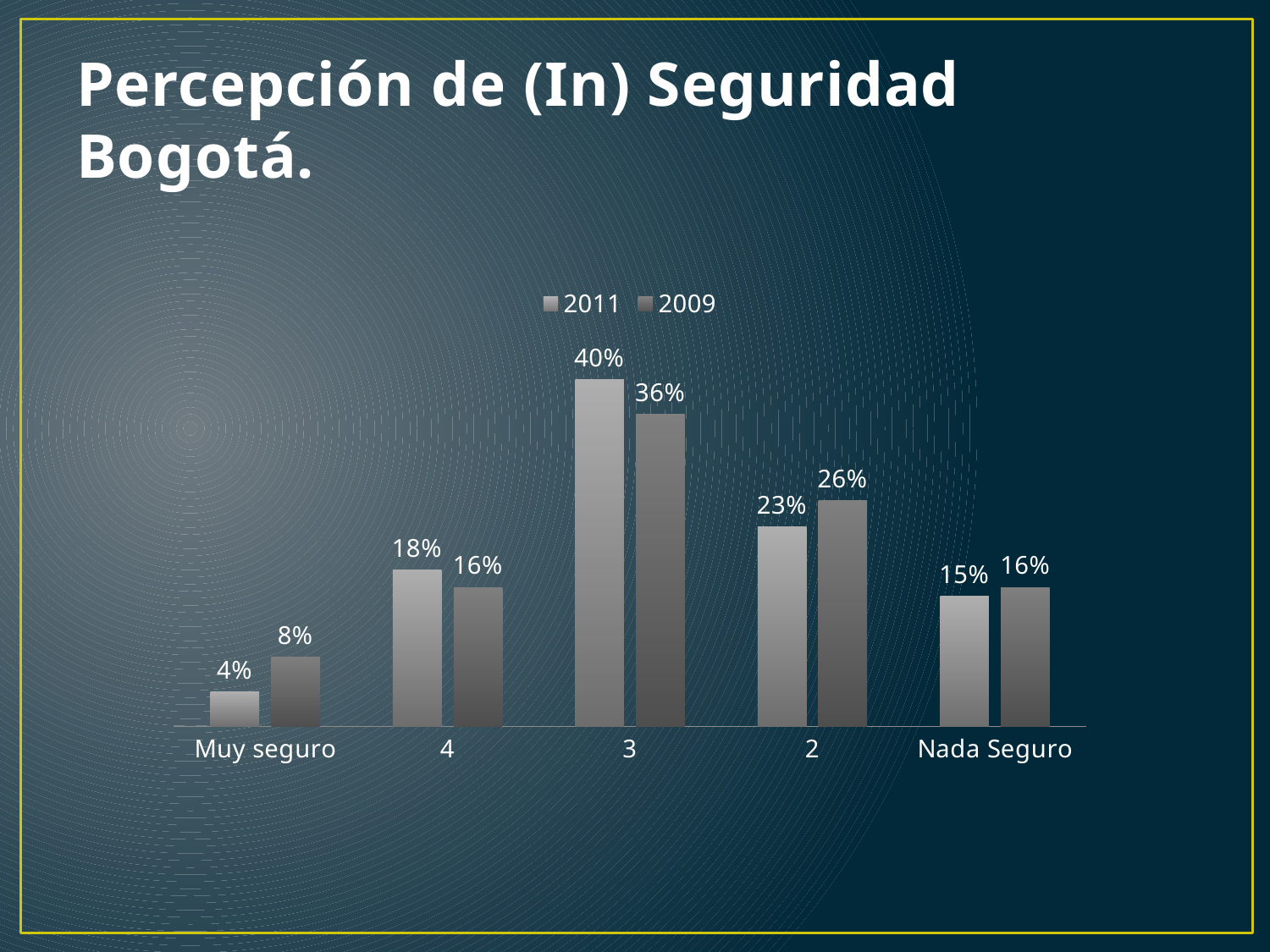
What is the 2011 value for "Nada Seguro"? 15% Which category has the lowest 2009 value? Muy seguro Which is larger for the category "4": the 2011 value or the 2009 value? 2011 What is the 2009 value for the category "2"? 26% What is the 2009 value for "Muy seguro"? 8% How many series does the legend list? 2 Which category has the highest 2011 value? 3 What is the 2011 value for the category "3"? 40% How many categories are shown on the x axis? 5 What is the difference between the 2011 and 2009 values for the category "3"? 4% What kind of chart is shown on the slide? Bar chart What is the title of the slide? Percepción de (In) Seguridad Bogotá.